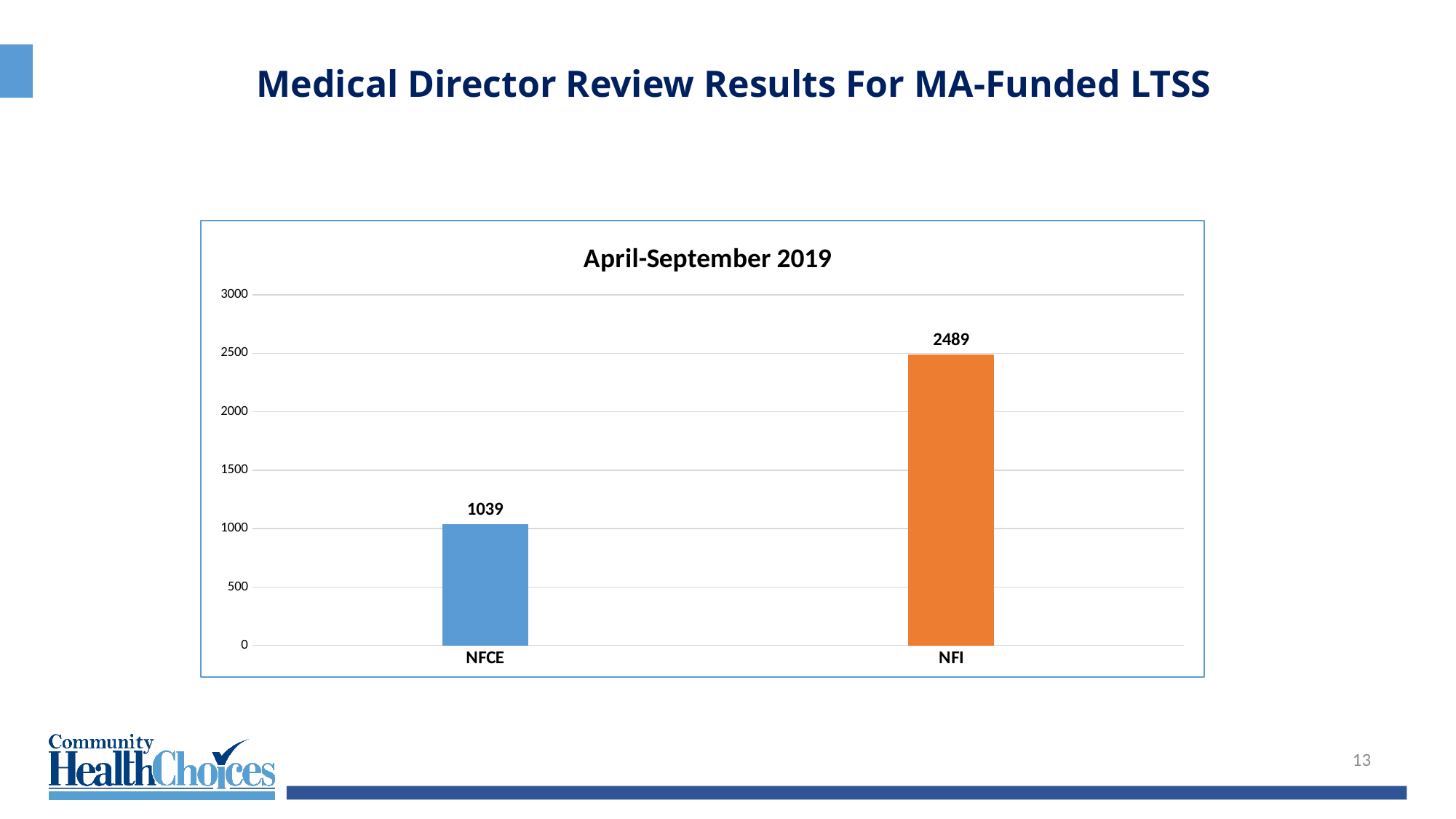
What is the title of the chart? April-September 2019 Is the value for NFCE greater or less than 1500? less Which is larger, the value for NFCE or the value for NFI? NFI Which category has the lowest value? NFCE What is the value for NFCE? 1039 What colour is the bar for NFI? orange How many categories are shown on the chart? 2 Which category has the highest value? NFI What is the difference between the values for NFI and NFCE? 1450 What kind of chart is shown on the slide? bar chart What is the value for NFI? 2489 Is the value for NFI greater or less than 2000? greater